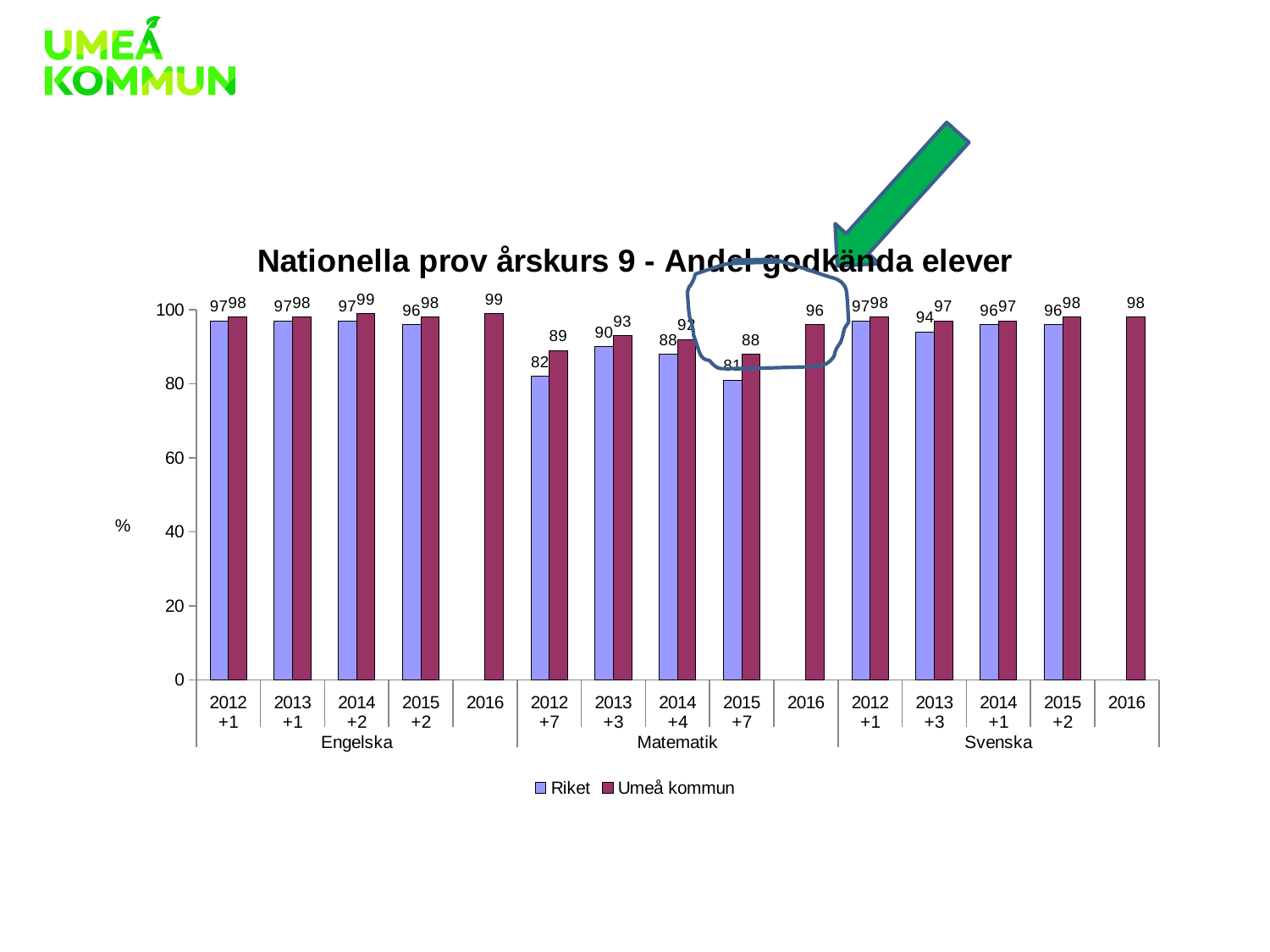
Which is larger in Matematik 2013: Riket or Umeå kommun? Umeå kommun What is the value for Riket in Svenska 2013? 94 Which year in the Matematik group has the lowest value for Umeå kommun? 2015 Is the value for Riket in Matematik 2012 greater or less than 80? greater How many series does the legend list? 2 What is the value for Umeå kommun in Matematik 2016? 96 What is the difference between Umeå kommun and Riket in Svenska 2013? 3 What is the difference between Umeå kommun and Riket in Matematik 2012? 7 What is the value for Riket in Matematik 2012? 82 What is the title of the chart? Nationella prov årskurs 9 - Andel godkända elever What is the value for Umeå kommun in Engelska 2014? 99 What kind of chart is shown on the slide? Bar chart